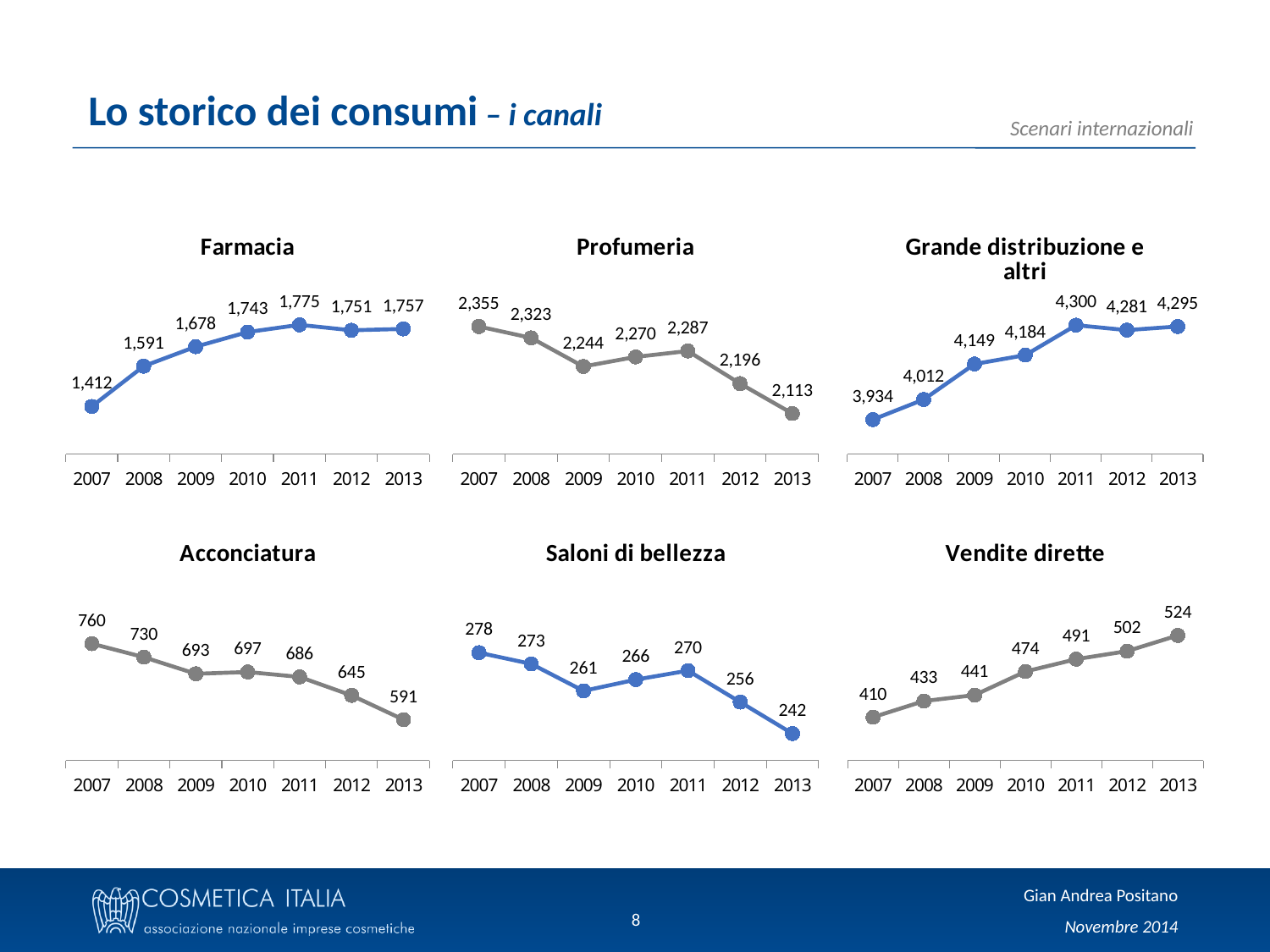
What kind of chart is the Profumeria chart? line chart In the Saloni di bellezza chart, which is larger, the value for 2010 or the value for 2011? 2011 In the Grande distribuzione e altri chart, which year has the highest value? 2011 How many charts are shown on the slide? 6 In the Profumeria chart, what is the value for 2013? 2,113 In the Farmacia chart, what is the difference between the 2011 value and the 2012 value? 24 How many data points are plotted in the Farmacia chart? 7 In the Vendite dirette chart, what is the difference between the 2013 value and the 2007 value? 114 In the Acconciatura chart, which year has the lowest value? 2013 In the Farmacia chart, what is the value for 2007? 1,412 In the Grande distribuzione e altri chart, what is the value for 2009? 4,149 In the Vendite dirette chart, do the values rise or fall from 2007 to 2013? rise